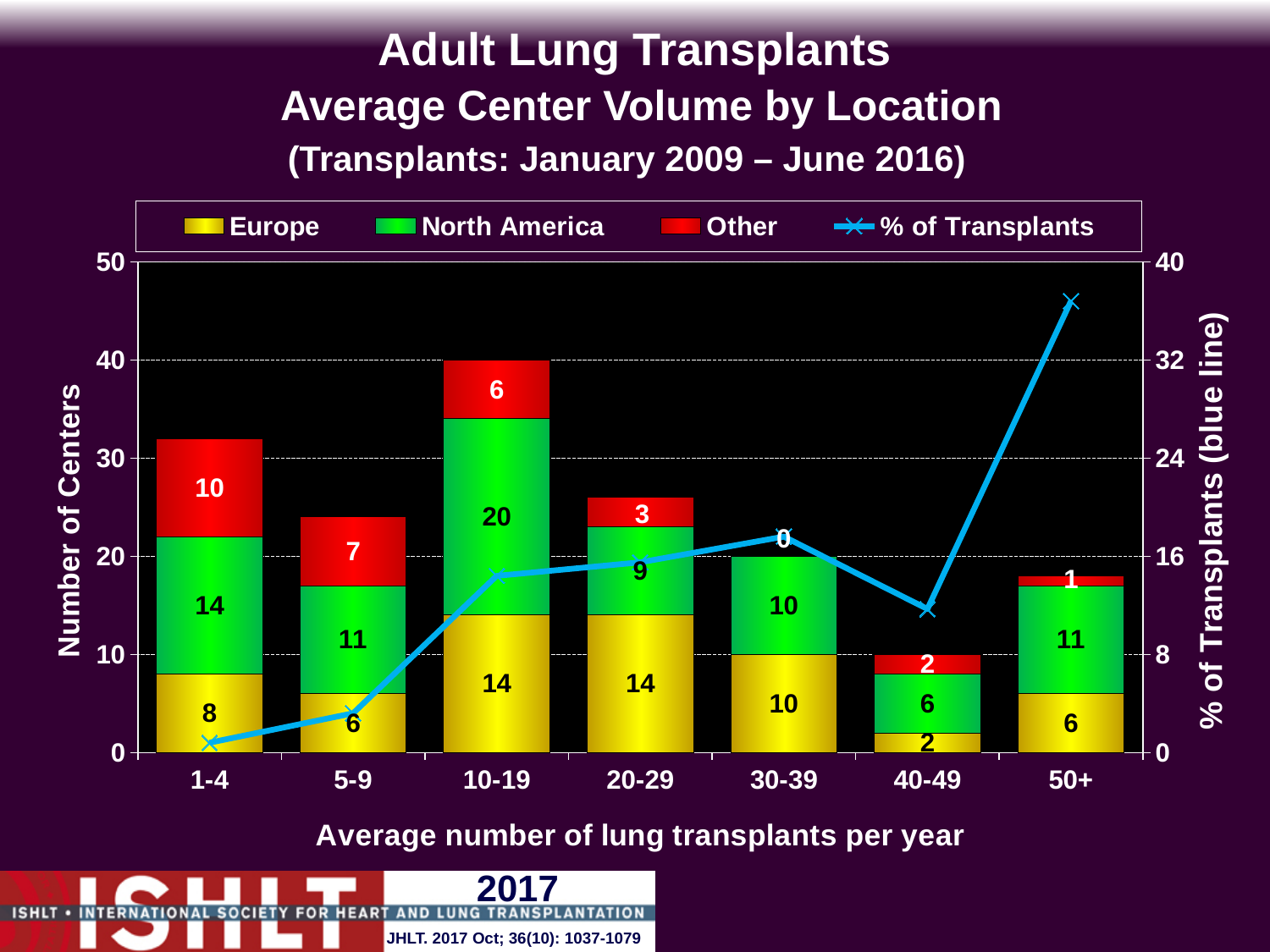
What kind of chart is this? Stacked bar chart with a line How many categories are shown on the x axis? 7 How many series does the legend list? 4 Which category has the lowest Europe value? 40-49 What is the difference between the North America values for 10-19 and 20-29? 11 What is the value for Other in the 1-4 category? 10 What is the total number of centers in the 10-19 category? 40 Which category has the larger Other value, 1-4 or 5-9? 1-4 Which category has the highest North America value? 10-19 Is the % of Transplants value for the 50+ category greater or less than 32? greater How many centers in Europe have an average of 10-19 lung transplants per year? 14 What is the North America value for the 30-39 category? 10